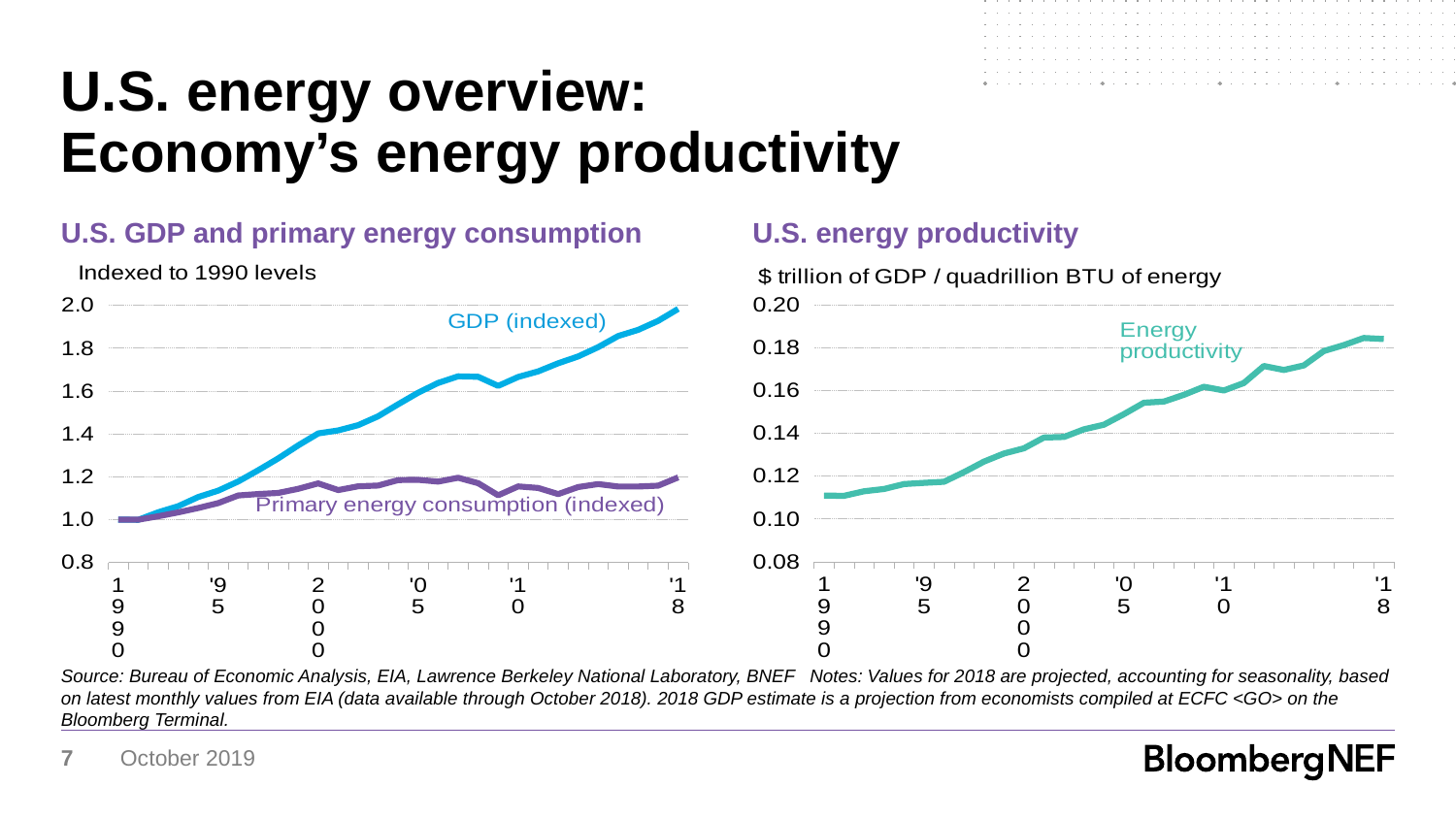
On the 'U.S. GDP and primary energy consumption' chart, does the GDP (indexed) line generally rise or fall from 1990 to 2018? Rise How many series are plotted on the 'U.S. GDP and primary energy consumption' chart? 2 On the 'U.S. GDP and primary energy consumption' chart, is the value for GDP (indexed) in 2000 greater or less than 1.2? greater On the 'U.S. GDP and primary energy consumption' chart, is the value for GDP (indexed) in 2018 greater or less than 1.8? greater How many series are plotted on the 'U.S. energy productivity' chart? 1 On the 'U.S. energy productivity' chart, is the value for Energy productivity in 2018 greater or less than 0.16? greater What kind of chart is the 'U.S. GDP and primary energy consumption' chart? Line chart On the 'U.S. energy productivity' chart, does the Energy productivity line generally rise or fall from 1990 to 2018? Rise On the 'U.S. GDP and primary energy consumption' chart, which series has the higher value in 2018, GDP (indexed) or Primary energy consumption (indexed)? GDP (indexed) What unit is shown above the 'U.S. energy productivity' chart? $ trillion of GDP / quadrillion BTU of energy